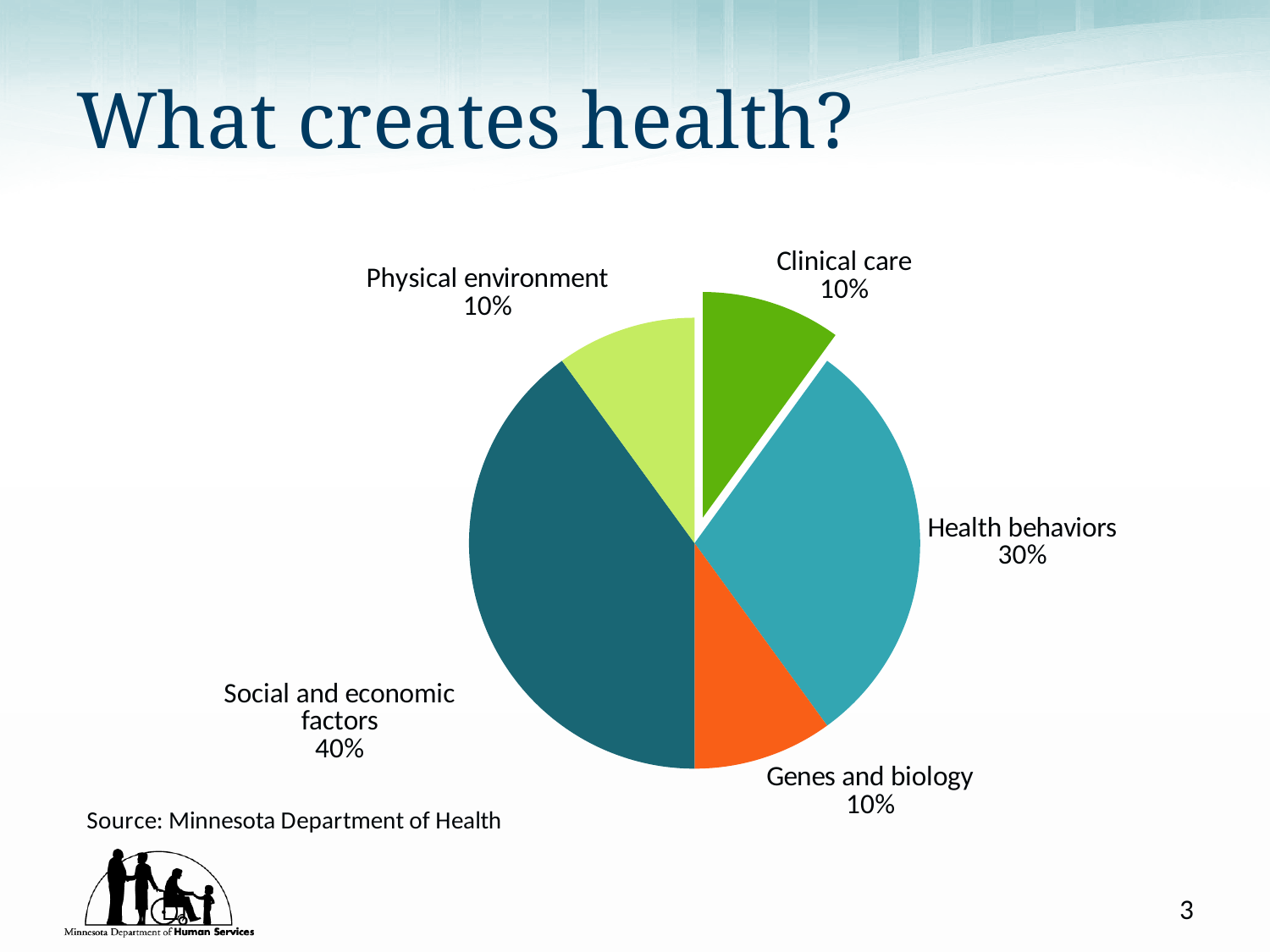
What is the difference between Social and economic factors and Health behaviors? 10% What is the difference between Health behaviors and Clinical care? 20% What is the value for Clinical care? 10% What is the value for Health behaviors? 30% What share of the pie is Social and economic factors? 40% What is the value for Genes and biology? 10% How many slices does the pie chart have? 5 Which slice is pulled out (exploded) from the pie? Clinical care What kind of chart is shown on the slide? pie chart What source is cited below the chart? Minnesota Department of Health Which category has the largest slice of the pie? Social and economic factors Which is larger, Health behaviors or Physical environment? Health behaviors